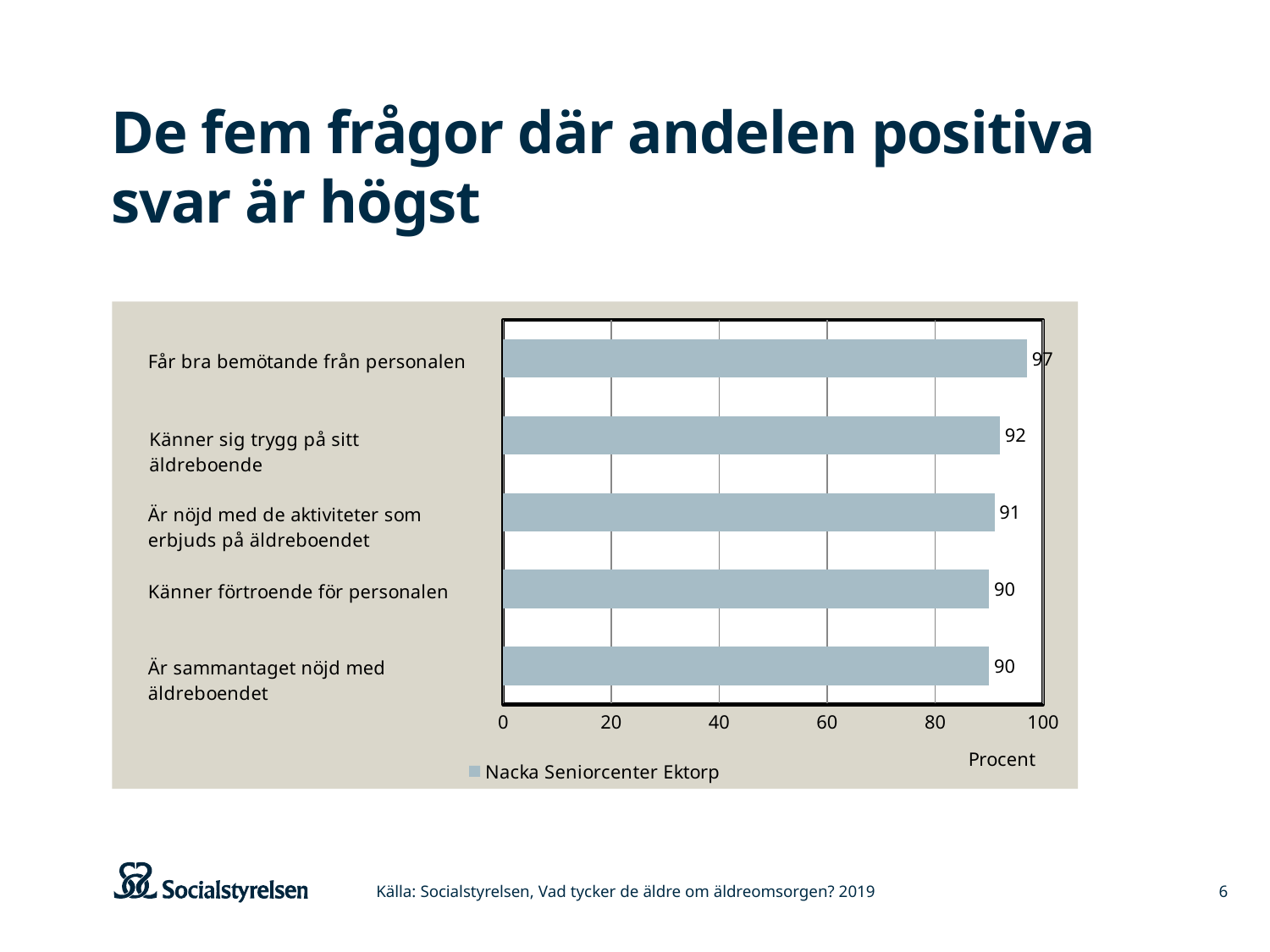
What is the value for "Känner sig trygg på sitt äldreboende"? 92 Which is larger, the value for "Känner sig trygg på sitt äldreboende" or the value for "Känner förtroende för personalen"? Känner sig trygg på sitt äldreboende Which category has the highest value? Får bra bemötande från personalen Is the value for "Är sammantaget nöjd med äldreboendet" greater or less than 80? greater What is the value for "Känner förtroende för personalen"? 90 What is the difference between the values for "Får bra bemötande från personalen" and "Är sammantaget nöjd med äldreboendet"? 7 How many series does the legend list? 1 How many categories are shown in the chart? 5 What kind of chart is shown on the slide? bar chart What is the name of the series in the legend? Nacka Seniorcenter Ektorp What is the value for "Är nöjd med de aktiviteter som erbjuds på äldreboendet"? 91 What is the value for "Får bra bemötande från personalen"? 97